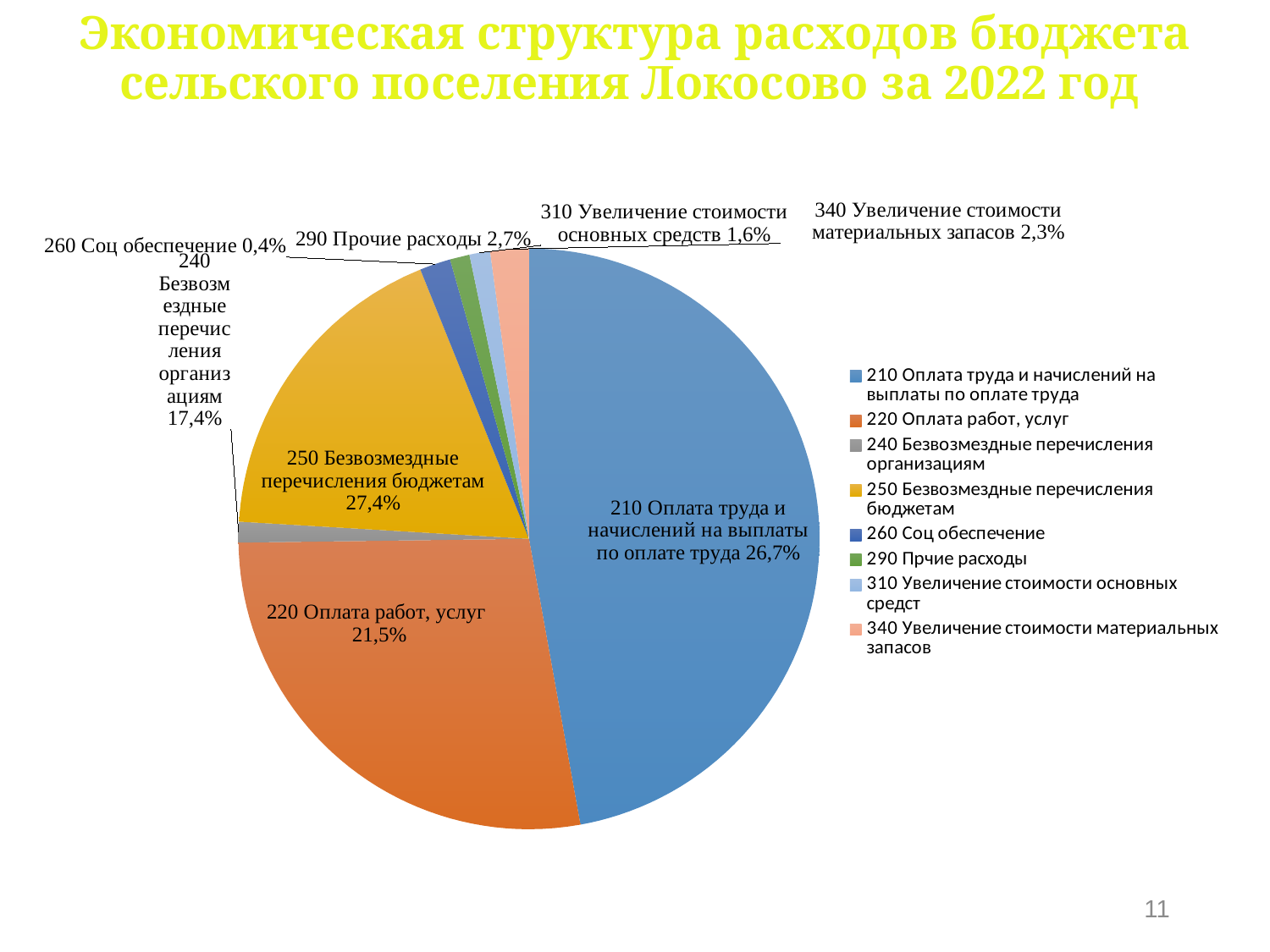
Which category has the smallest labelled share? 260 Соц обеспечение What share is labelled for 250 Безвозмездные перечисления бюджетам? 27,4% What share is labelled for 340 Увеличение стоимости материальных запасов? 2,3% What share is labelled for 220 Оплата работ, услуг? 21,5% What share is labelled for 290 Прочие расходы? 2,7% What share is labelled for 210 Оплата труда и начислений на выплаты по оплате труда? 26,7% How many entries does the legend list? 8 What kind of chart is shown on the slide? pie chart What share is labelled for 240 Безвозмездные перечисления организациям? 17,4% What share is labelled for 310 Увеличение стоимости основных средств? 1,6% What is the difference between the labelled shares of 290 Прочие расходы and 310 Увеличение стоимости основных средств? 1,1% What share is labelled for 260 Соц обеспечение? 0,4%